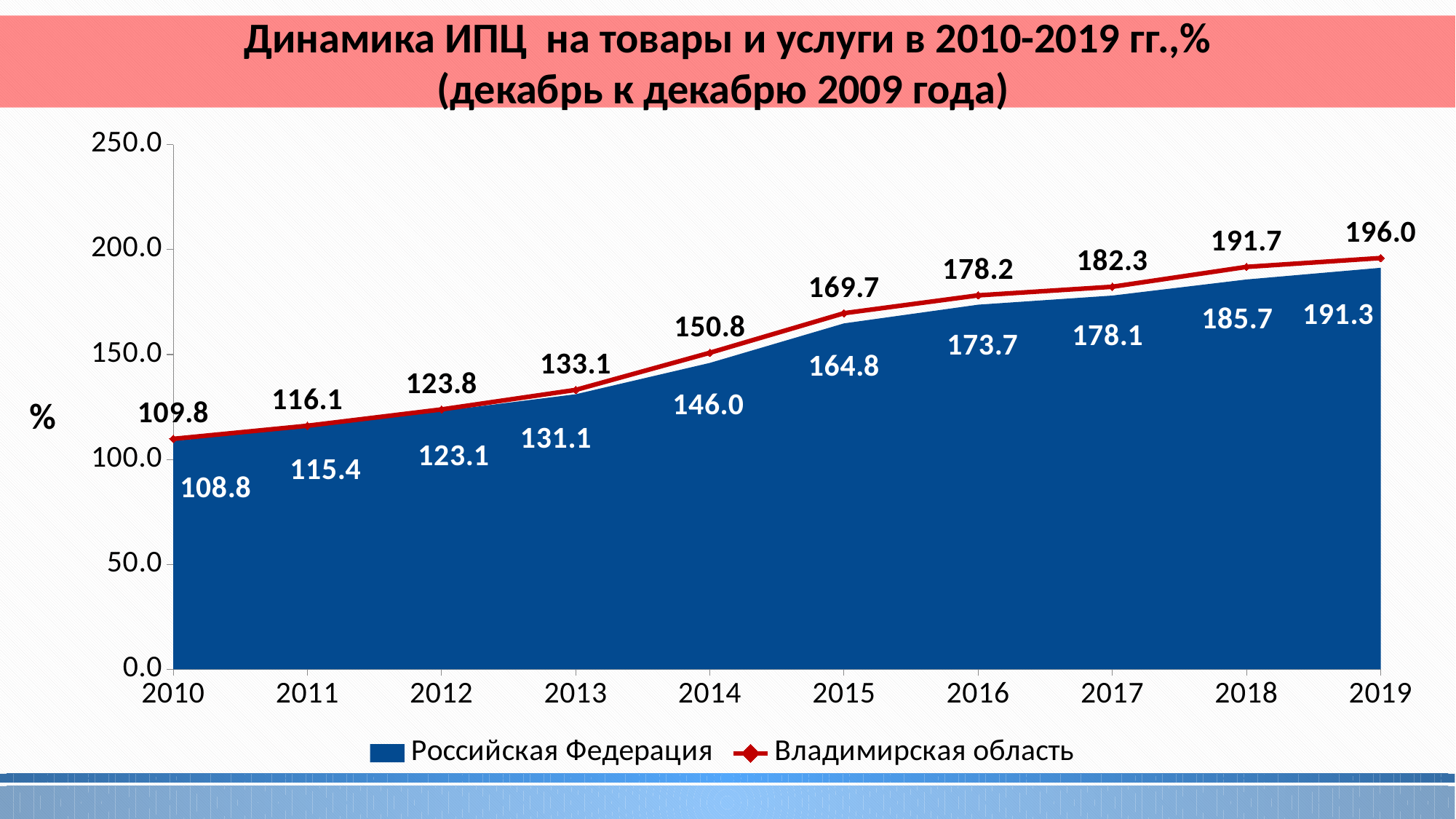
How many series does the legend list? 2 Which is larger in 2016: the value for Владимирская область or for Российская Федерация? Владимирская область What is the difference between the Владимирская область and Российская Федерация values in 2019? 4.7 What is the difference between the Владимирская область values in 2018 and 2017? 9.4 In which year is the value for Владимирская область highest? 2019 What is the value for Российская Федерация in 2019? 191.3 In which year is the value for Российская Федерация lowest? 2010 What is the value for Российская Федерация in 2014? 146.0 What is the value for Владимирская область in 2015? 169.7 What kind of chart is shown on the slide? combined area and line chart Do the values for Российская Федерация rise or fall from 2010 to 2019? rise How many years are shown on the x axis? 10